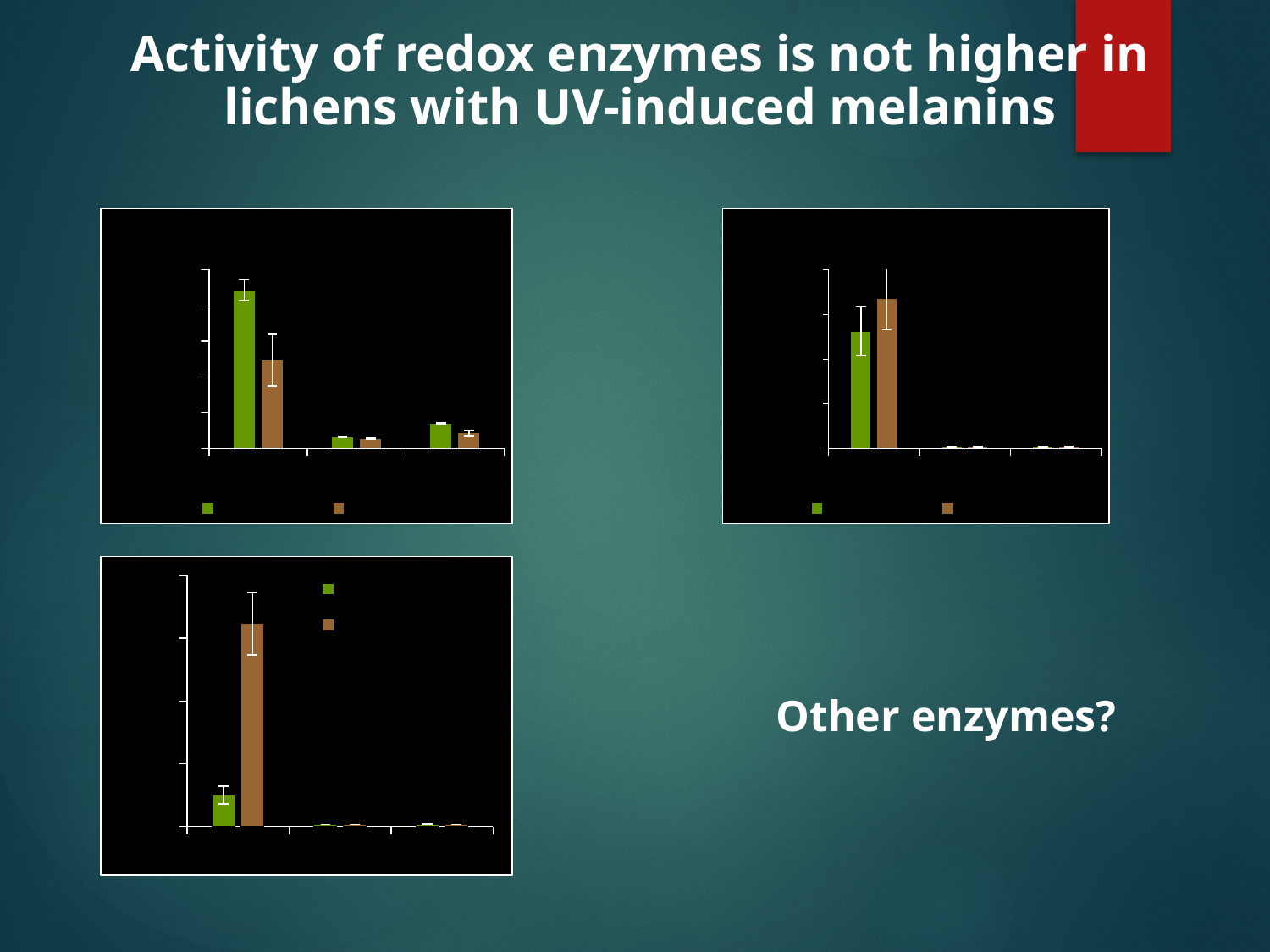
How many series does the legend of the top-left chart list? 2 In the top-left chart, which is taller in the leftmost group of bars, the green bar or the brown bar? green bar How many groups of bars are plotted along the x axis of the top-right chart? 3 How many series does the legend of the bottom-left chart list? 2 In the bottom-left chart, which is taller in the leftmost group of bars, the green bar or the brown bar? brown bar In the top-right chart, which is taller in the leftmost group of bars, the green bar or the brown bar? brown bar What two colours are used for the bars in the charts on this slide? green and brown What kind of chart is the bottom-left chart? bar chart What kind of chart is the top-right chart? bar chart How many groups of bars are plotted along the x axis of the top-left chart? 3 What kind of chart is the top-left chart? bar chart In the top-left chart, which group of bars along the x axis has the tallest bar: the first, second or third? first